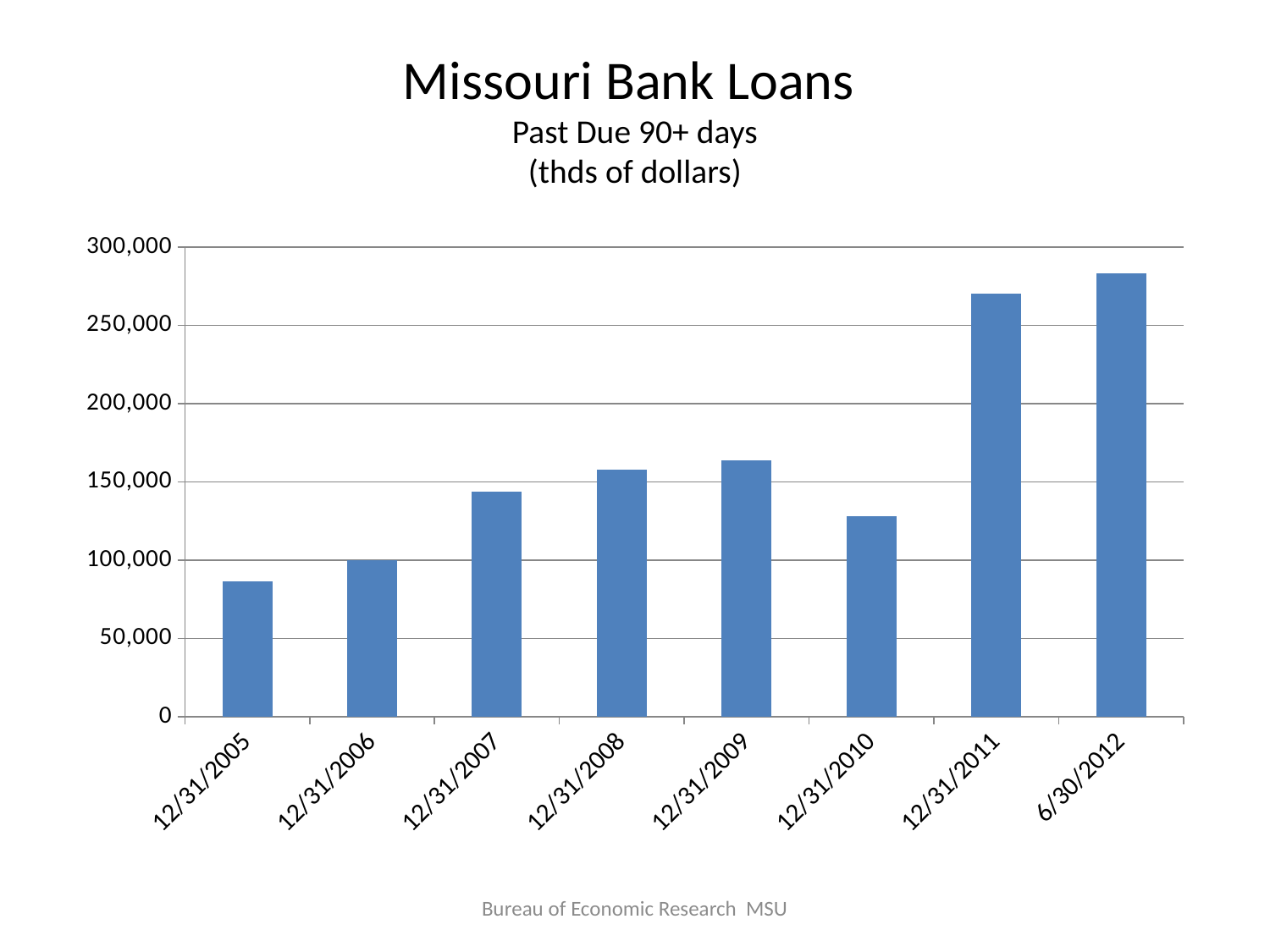
Is the value for 12/31/2010 greater or less than 150,000? less Is the value for 12/31/2011 greater or less than 250,000? greater In what units are the values on the chart expressed, according to the subtitle? thds of dollars Do the values rise or fall from 12/31/2005 to 12/31/2009? rise What kind of chart is shown on the slide? bar chart How many dates are plotted on the x axis? 8 Which date has the highest value for past due loans? 6/30/2012 Is the value for 6/30/2012 greater or less than 300,000? less Which is larger, the value for 12/31/2007 or the value for 12/31/2010? 12/31/2007 Which date has the lowest value for past due loans? 12/31/2005